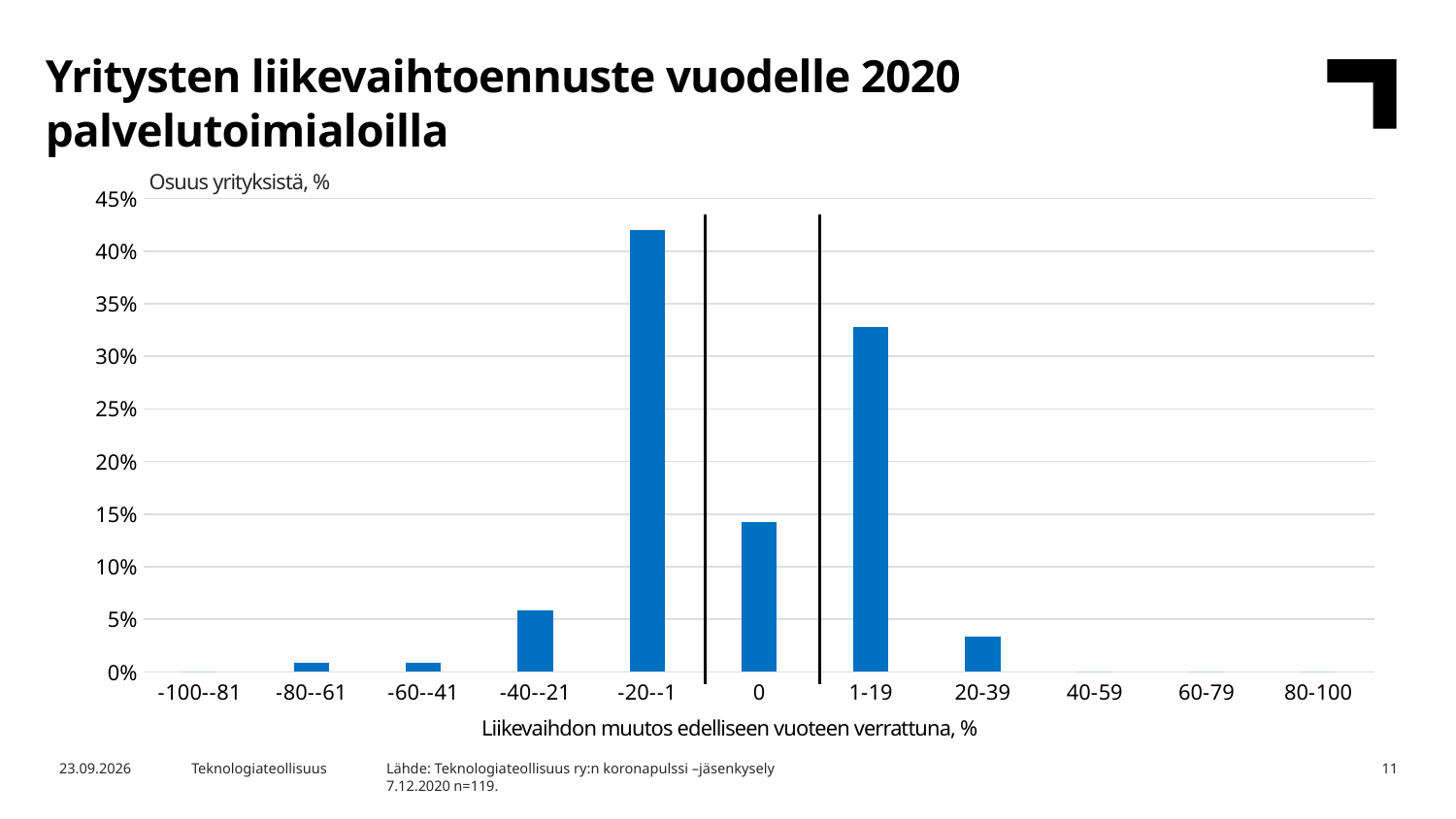
Is the value for 0 greater or less than 15%? less Which category has the highest share of companies? -20--1 What is the label of the x axis? Liikevaihdon muutos edelliseen vuoteen verrattuna, % Which is larger, the value for 0 or the value for -40--21? 0 Is the value for -40--21 greater or less than 10%? less How many categories are shown on the x axis? 11 Which is larger, the value for -20--1 or the value for 1-19? -20--1 Is the value for 1-19 greater or less than 30%? greater What is the label of the y axis? Osuus yrityksistä, % What kind of chart is shown on the slide? bar chart